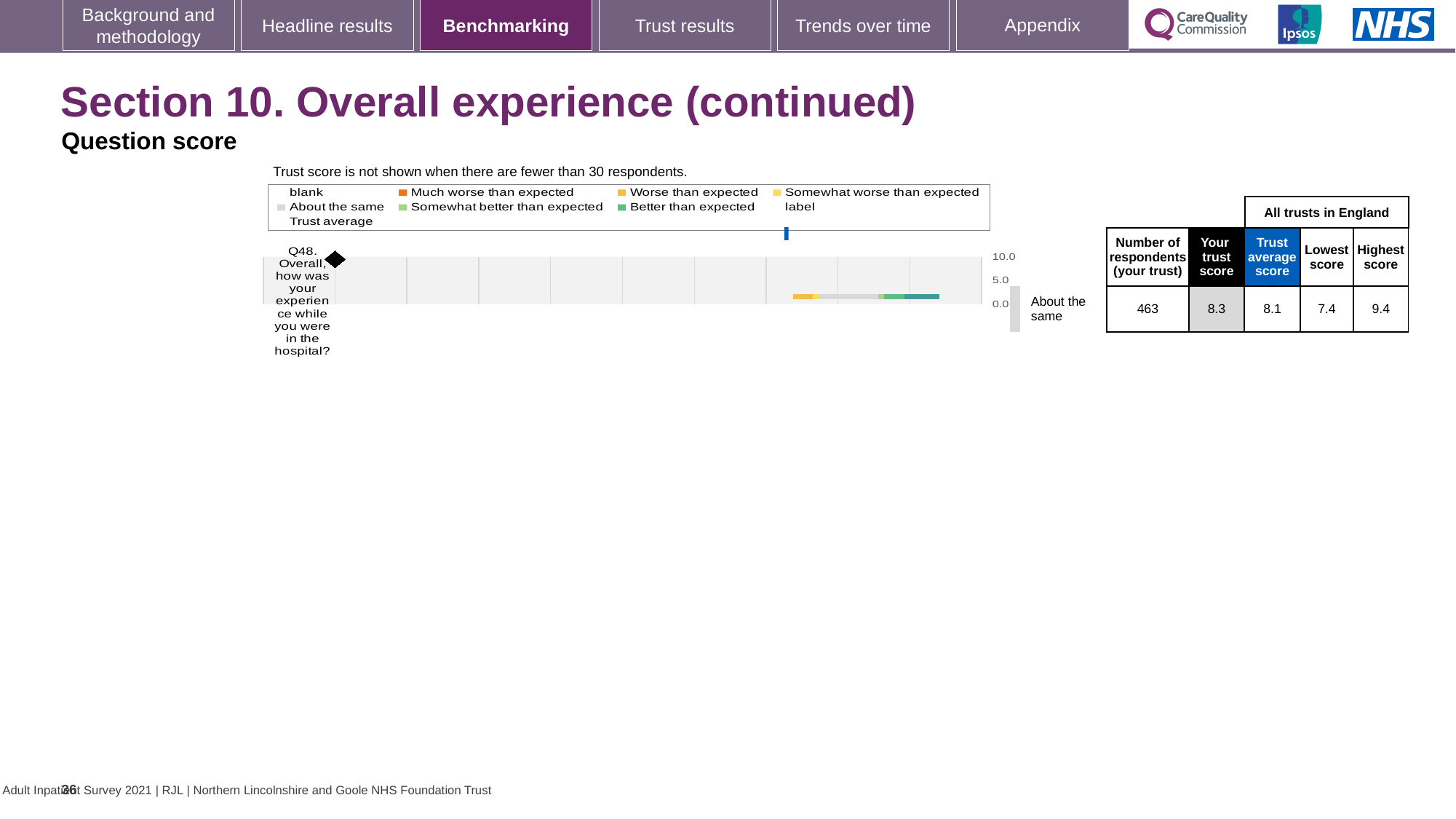
What is the difference between the highest and lowest scores for Q48 across all trusts in England? 2.0 Which is larger for Q48: the trust's own score or the trust average score? Your trust score Which benchmark category is the trust's Q48 result placed in? About the same How many respondents from the trust answered Q48? 463 What is the lowest score among all trusts in England for Q48? 7.4 By how much does the trust's score for Q48 exceed the trust average score? 0.2 Is the trust score for Q48 greater or less than 5.0 on the chart axis? greater What is the trust score for Q48 (Overall, how was your experience while you were in the hospital?)? 8.3 What is the highest score among all trusts in England for Q48? 9.4 How many questions are plotted on the benchmarking chart? 1 What is the trust average score for Q48 across all trusts in England? 8.1 What kind of chart is used to show the Q48 benchmarking result? bar chart